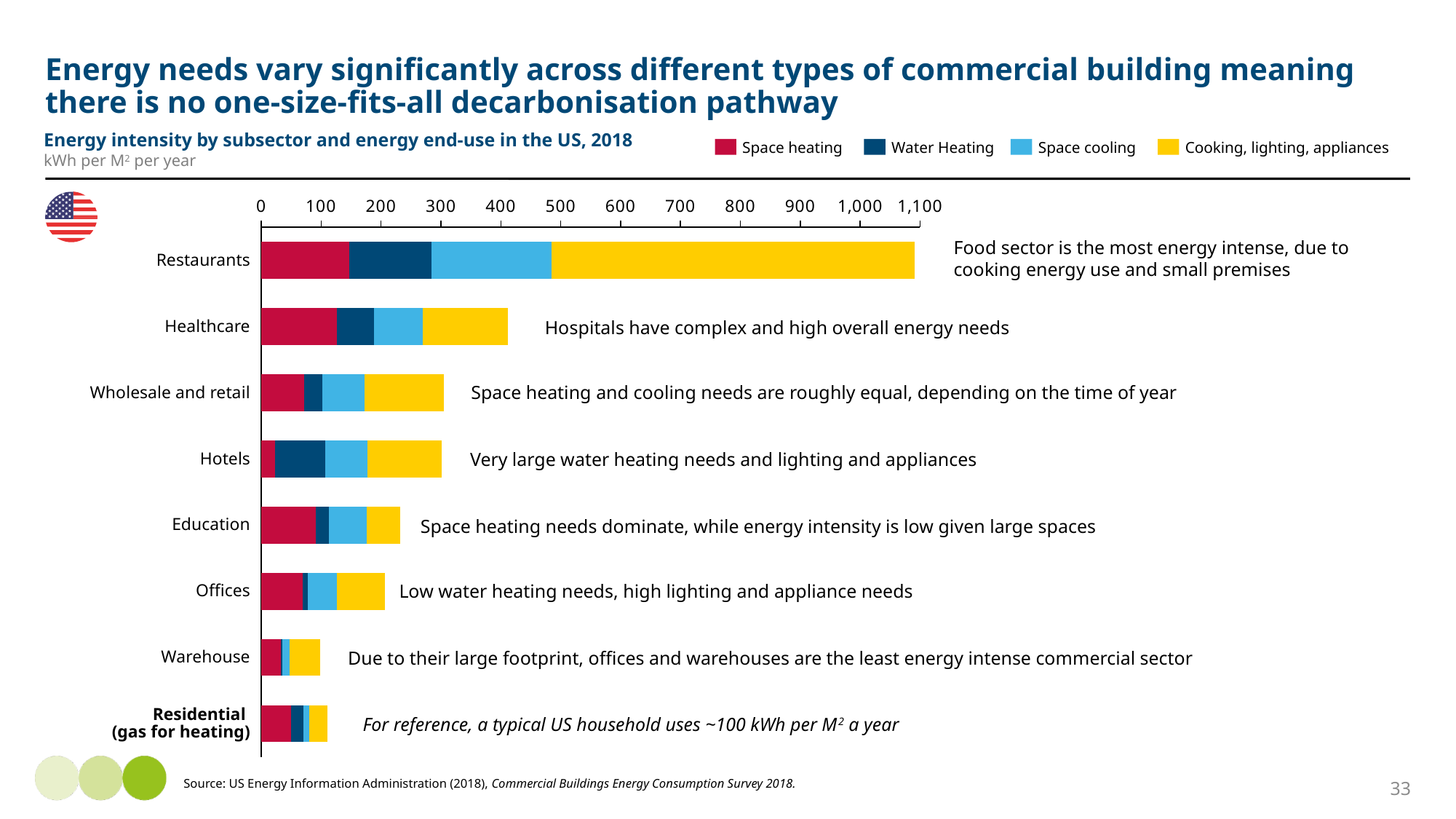
Is the total energy intensity for Restaurants greater or less than 1,000 kWh per M2 per year? greater Is the total energy intensity for Education greater or less than 300? less What kind of chart is shown on the slide? Stacked bar chart Is the total energy intensity for Warehouse greater or less than 200? less How many building subsectors (categories) are plotted in the chart? 8 Which subsector has the highest total energy intensity? Restaurants Which has a larger total energy intensity, Healthcare or Education? Healthcare How many energy end-use series does the legend list? 4 What unit is the energy intensity measured in, according to the chart subtitle? kWh per M2 per year Which has a larger total energy intensity, Restaurants or Hotels? Restaurants